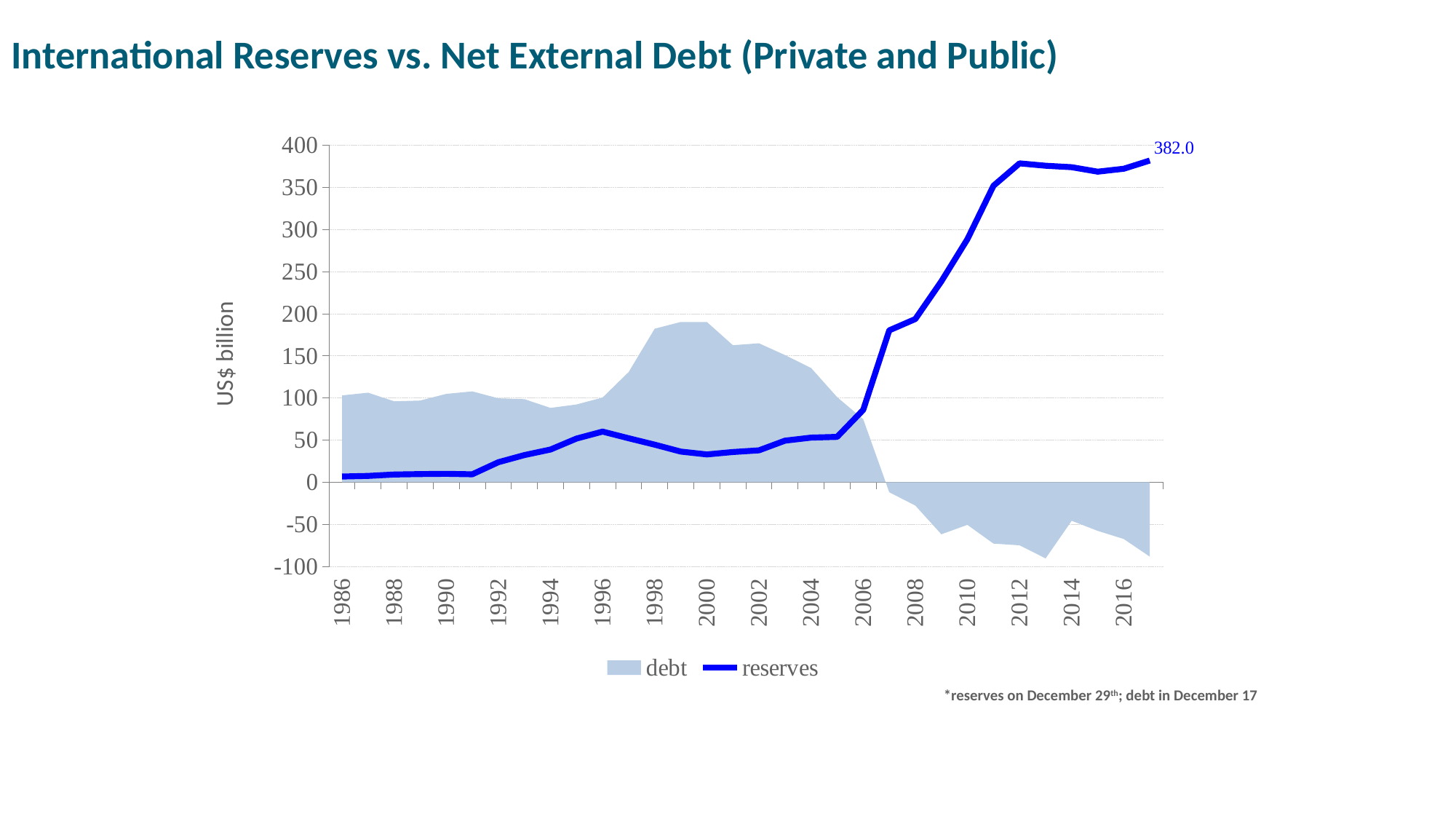
What kind of chart is used to plot the reserves series? line chart How many series does the legend list? 2 Do reserves rise or fall between 2006 and 2012? rise In 2000, which is larger, debt or reserves? debt Is the value of debt in 2013 greater or less than -50? less Is the value of debt in 2000 greater or less than 150? greater What are the two series named in the legend? debt and reserves In 2012, which is larger, reserves or debt? reserves What is the label on the vertical axis? US$ billion What is the value of the data label shown at the end of the reserves line? 382.0 Is the value of reserves in 2012 greater or less than 350? greater